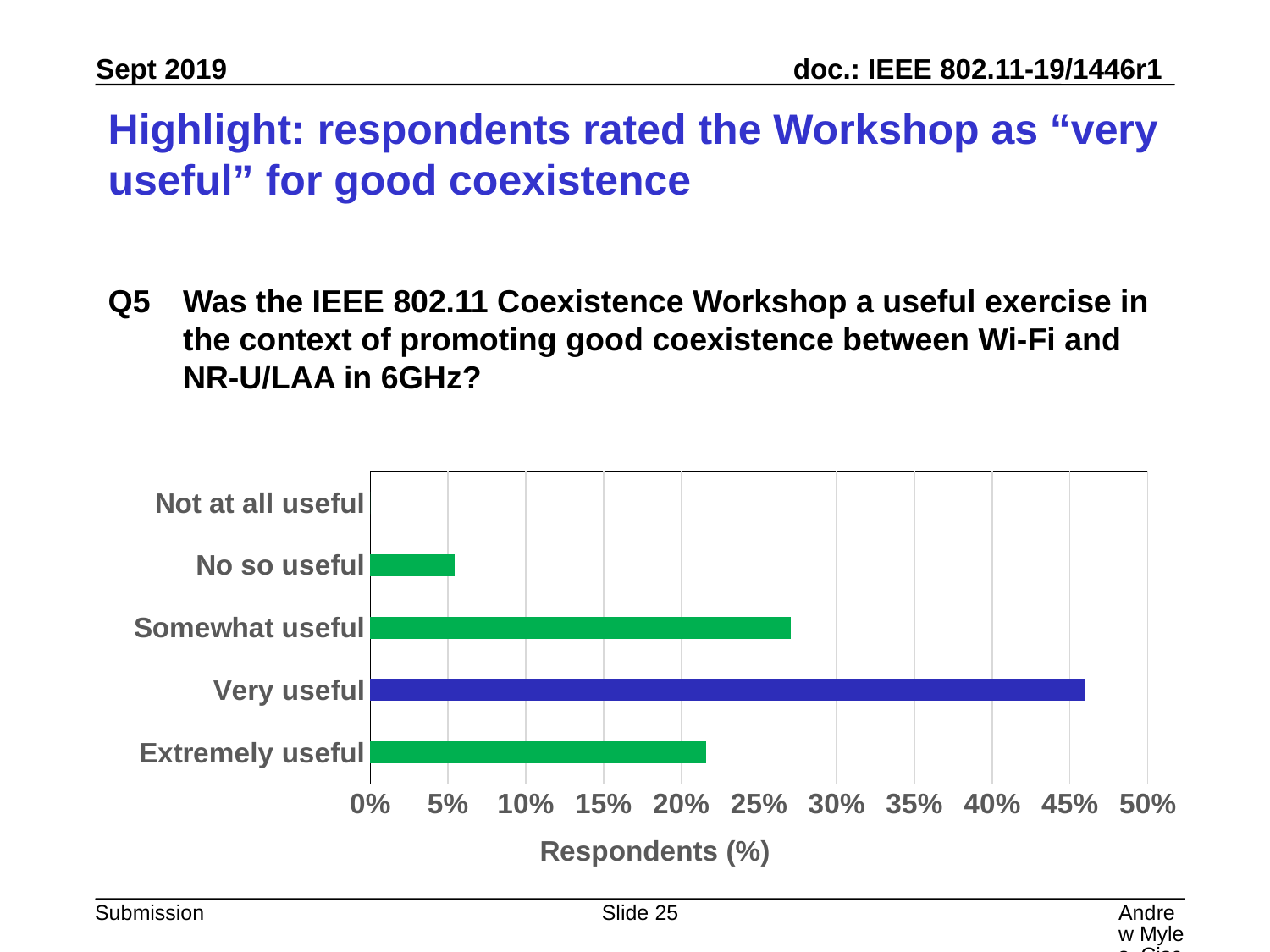
Which has a larger share of respondents, "Somewhat useful" or "Extremely useful"? Somewhat useful How many response categories are listed on the vertical axis of the chart? 5 Which has a larger share of respondents, "No so useful" or "Extremely useful"? Extremely useful Is the value for "No so useful" greater or less than 10%? less Is the value for "Very useful" greater or less than 40%? greater Is the value for "Somewhat useful" greater or less than 25%? greater Which response category has the highest percentage of respondents? Very useful What is the title of the horizontal axis of the chart? Respondents (%) Which response category has the lowest percentage of respondents? Not at all useful What colour is the bar for "Very useful"? blue What kind of chart is shown on the slide? bar chart